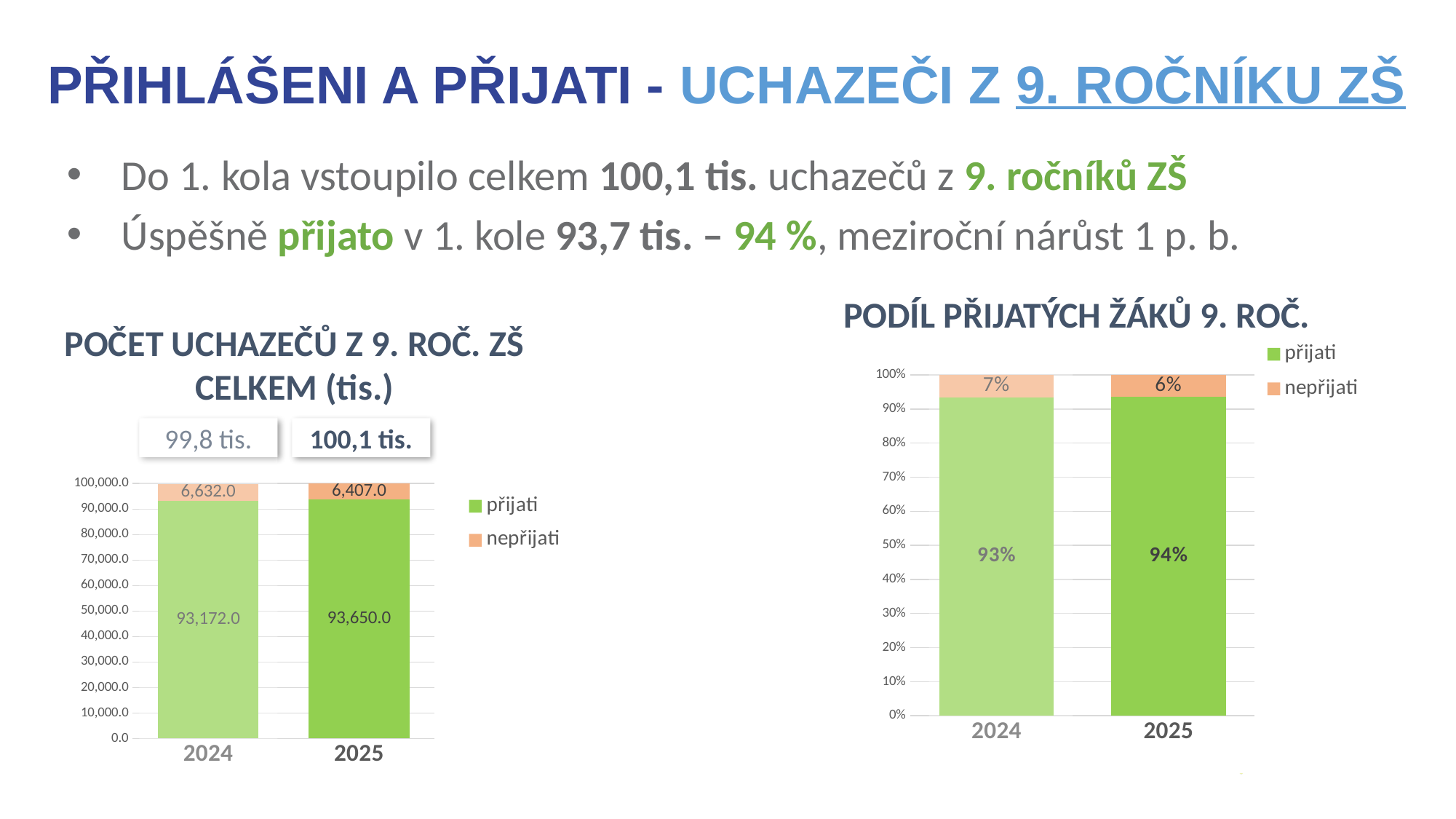
In the left chart (POČET UCHAZEČŮ Z 9. ROČ. ZŠ CELKEM), what is the difference between the přijati values for 2025 and 2024? 478.0 In the left chart (POČET UCHAZEČŮ Z 9. ROČ. ZŠ CELKEM), what is the value for nepřijati in 2024? 6,632.0 What kind of chart is the right chart (PODÍL PŘIJATÝCH ŽÁKŮ 9. ROČ.)? stacked bar chart In the right chart (PODÍL PŘIJATÝCH ŽÁKŮ 9. ROČ.), how many years are shown on the x axis? 2 In the left chart (POČET UCHAZEČŮ Z 9. ROČ. ZŠ CELKEM), what is the total of the stacked bar for 2025? 100,057.0 In the right chart (PODÍL PŘIJATÝCH ŽÁKŮ 9. ROČ.), what is the share of přijati in 2025? 94% In the right chart (PODÍL PŘIJATÝCH ŽÁKŮ 9. ROČ.), what is the share of nepřijati in 2024? 7% In the left chart (POČET UCHAZEČŮ Z 9. ROČ. ZŠ CELKEM), what is the value for přijati in 2024? 93,172.0 In the left chart (POČET UCHAZEČŮ Z 9. ROČ. ZŠ CELKEM), which year has the larger nepřijati value, 2024 or 2025? 2024 In the left chart (POČET UCHAZEČŮ Z 9. ROČ. ZŠ CELKEM), what is the value for nepřijati in 2025? 6,407.0 In the right chart (PODÍL PŘIJATÝCH ŽÁKŮ 9. ROČ.), does the share of přijati rise or fall from 2024 to 2025? rise In the left chart (POČET UCHAZEČŮ Z 9. ROČ. ZŠ CELKEM), how many series does the legend list? 2